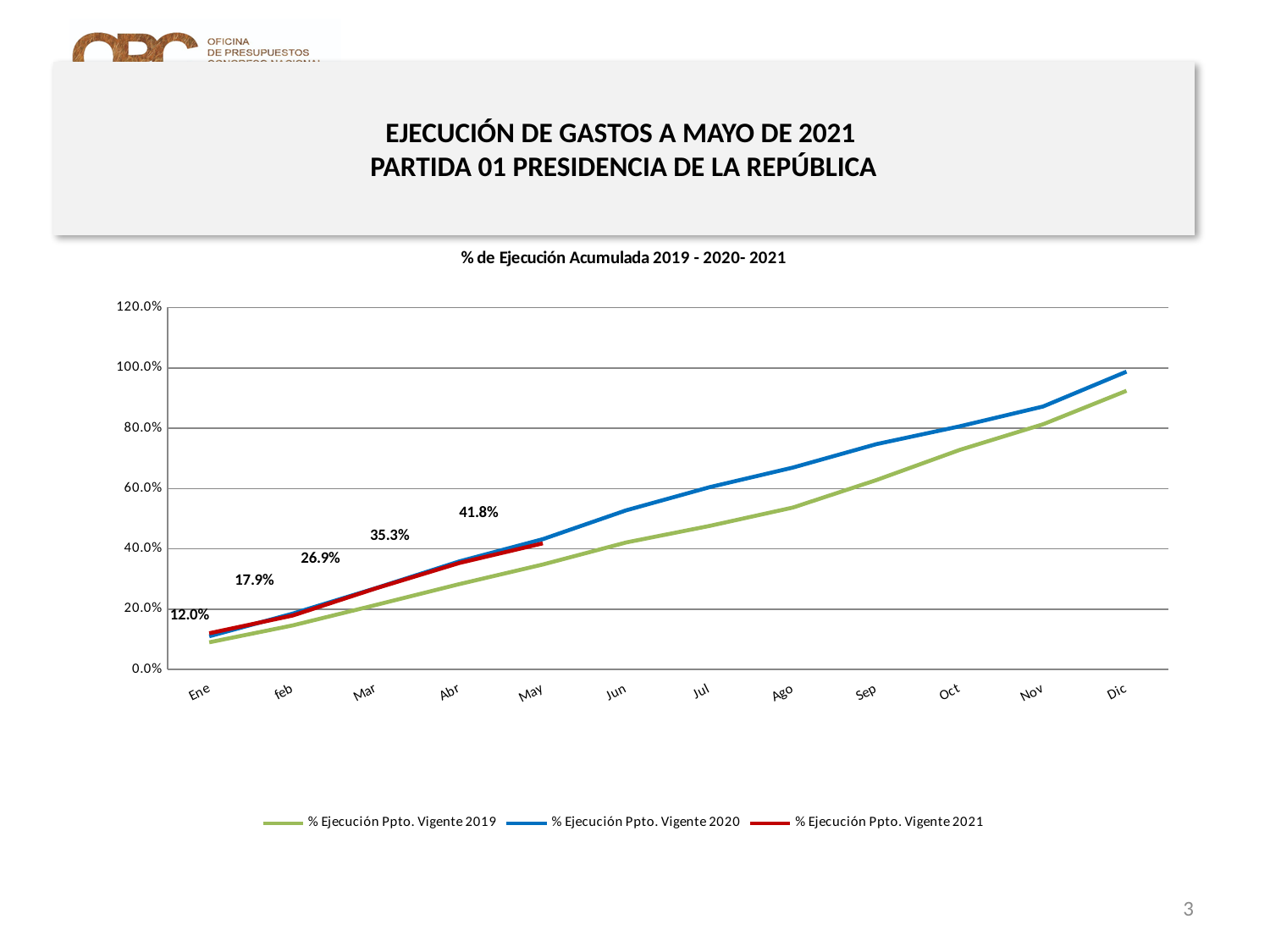
What is the value of % Ejecución Ppto. Vigente 2021 in Ene? 12.0% What is the value of % Ejecución Ppto. Vigente 2021 in May? 41.8% How many months are shown on the x axis? 12 What kind of chart is shown on the slide? Line chart Is the value for % Ejecución Ppto. Vigente 2020 in Dic greater or less than 80%? greater What is the difference between the 2021 values for May and Abr? 6.5% How many series does the legend list? 3 Among the labelled 2021 values, which month has the highest value? May What is the title of the chart? % de Ejecución Acumulada 2019 - 2020- 2021 What is the value of % Ejecución Ppto. Vigente 2021 in Mar? 26.9% What is the difference between the 2021 values for feb and Ene? 5.9% In Dic, which series is higher: % Ejecución Ppto. Vigente 2020 or % Ejecución Ppto. Vigente 2019? % Ejecución Ppto. Vigente 2020